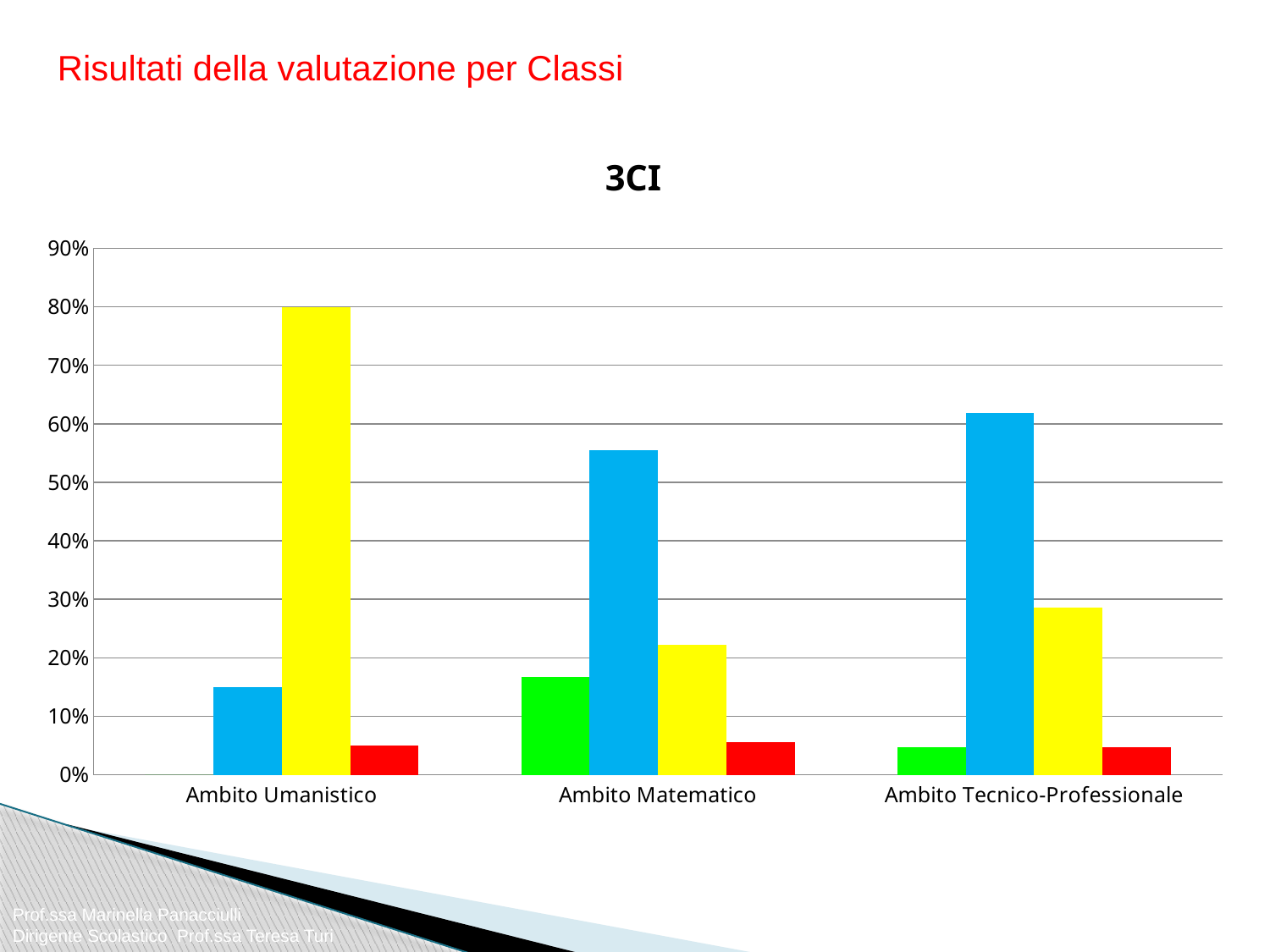
Which is larger, the green bar for Ambito Matematico or the green bar for Ambito Tecnico-Professionale? Ambito Matematico Is the yellow bar for Ambito Tecnico-Professionale greater or less than 30%? less Is the yellow bar for Ambito Umanistico greater or less than 70%? greater Which is larger, the blue bar for Ambito Matematico or the blue bar for Ambito Tecnico-Professionale? Ambito Tecnico-Professionale Which category has no green bar in the chart? Ambito Umanistico Is the blue bar for Ambito Matematico greater or less than 50%? greater Which category has the tallest bar in the chart? Ambito Umanistico What kind of chart is shown on the slide? bar chart What is the title of the chart? 3CI How many categories are shown on the x axis of the chart? 3